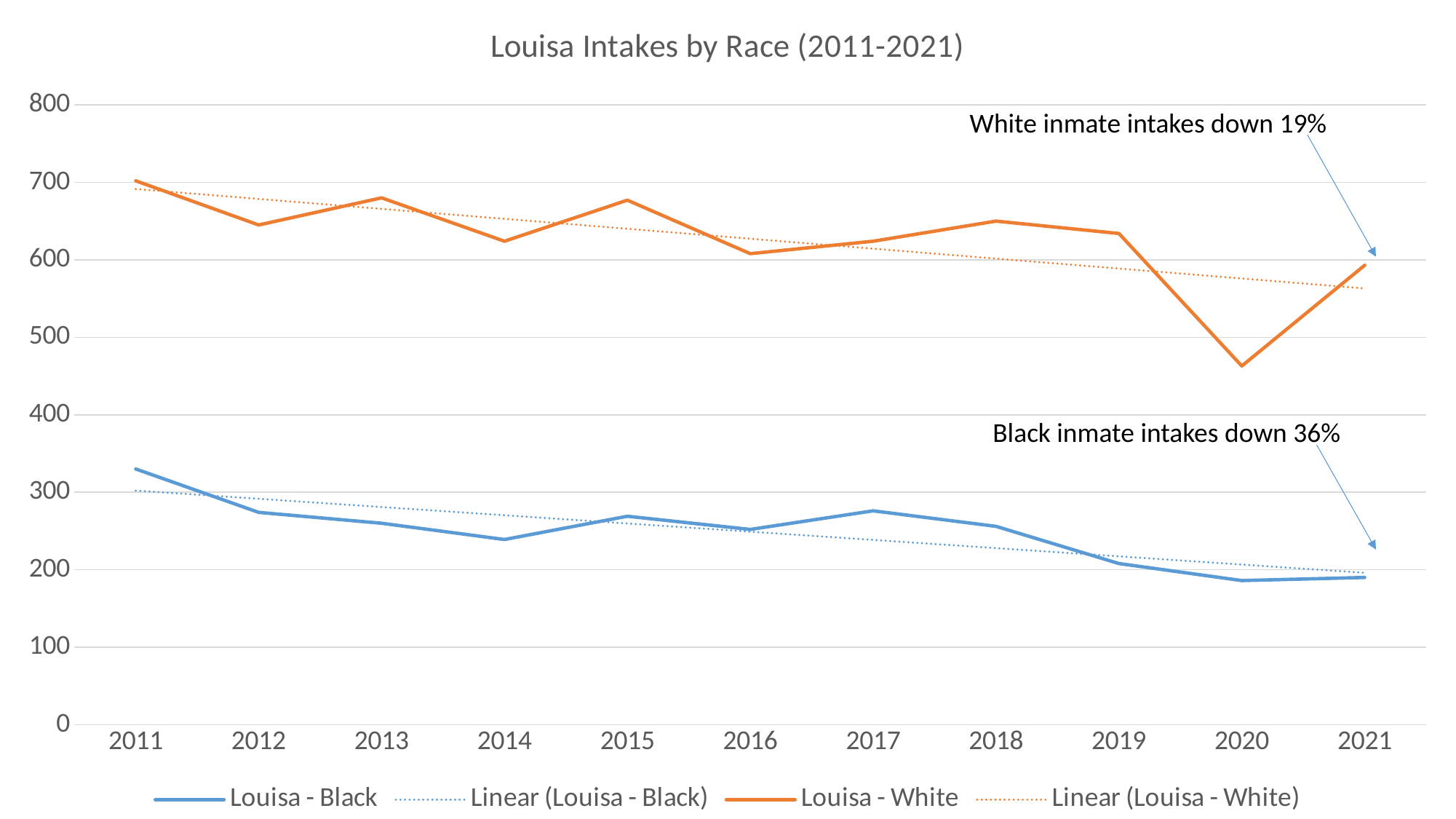
How many series does the legend list? 4 In which year is the Louisa - White series at its highest? 2011 Does the Louisa - Black series generally rise or fall from 2011 to 2021? fall What kind of chart is shown on the slide? line chart Is the value for Louisa - Black in 2011 greater or less than 300? greater What is the title of the chart? Louisa Intakes by Race (2011-2021) Which series has the larger value in 2017, Louisa - Black or Louisa - White? Louisa - White How many years are shown along the x axis? 11 Is the value for Louisa - White in 2020 greater or less than 500? less In which year is the Louisa - White series at its lowest? 2020 In which year is the Louisa - Black series at its highest? 2011